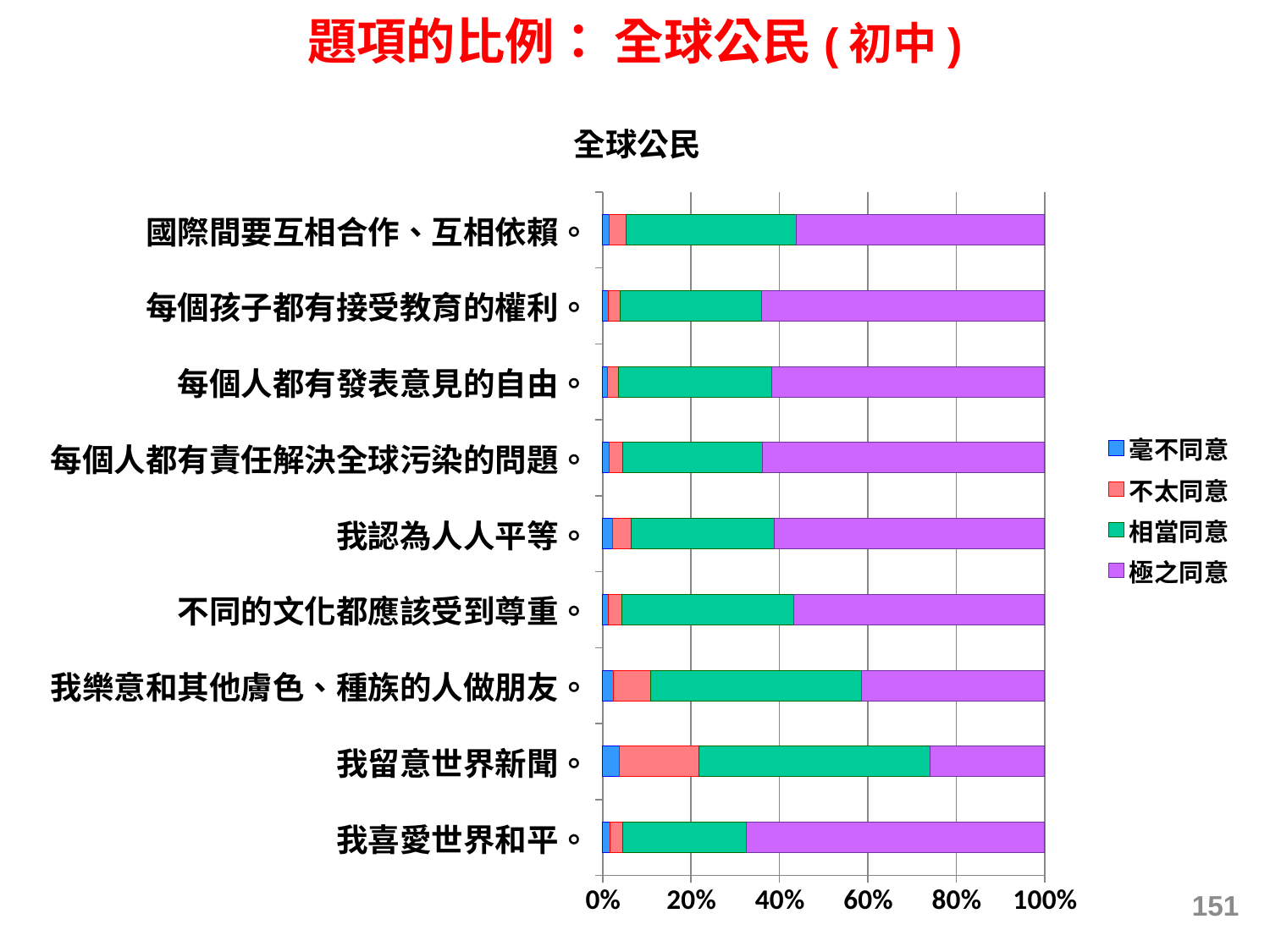
What is the title shown above the chart? 全球公民 How many items (categories) are plotted in the chart? 9 Which has the larger 相當同意 share: 我留意世界新聞。 or 我喜愛世界和平。? 我留意世界新聞。 Is the 極之同意 share for 我喜愛世界和平。 greater or less than 60%? greater Which has the larger 極之同意 share: 我留意世界新聞。 or 我喜愛世界和平。? 我喜愛世界和平。 Which legend entry is shown in purple? 極之同意 Is the 極之同意 share for 國際間要互相合作、互相依賴。 greater or less than 40%? greater Which item has the smallest 極之同意 share? 我留意世界新聞。 What kind of chart is shown on the slide? stacked bar chart Which item has the largest 不太同意 share? 我留意世界新聞。 Is the 極之同意 share for 我留意世界新聞。 greater or less than 40%? less How many series does the legend list? 4